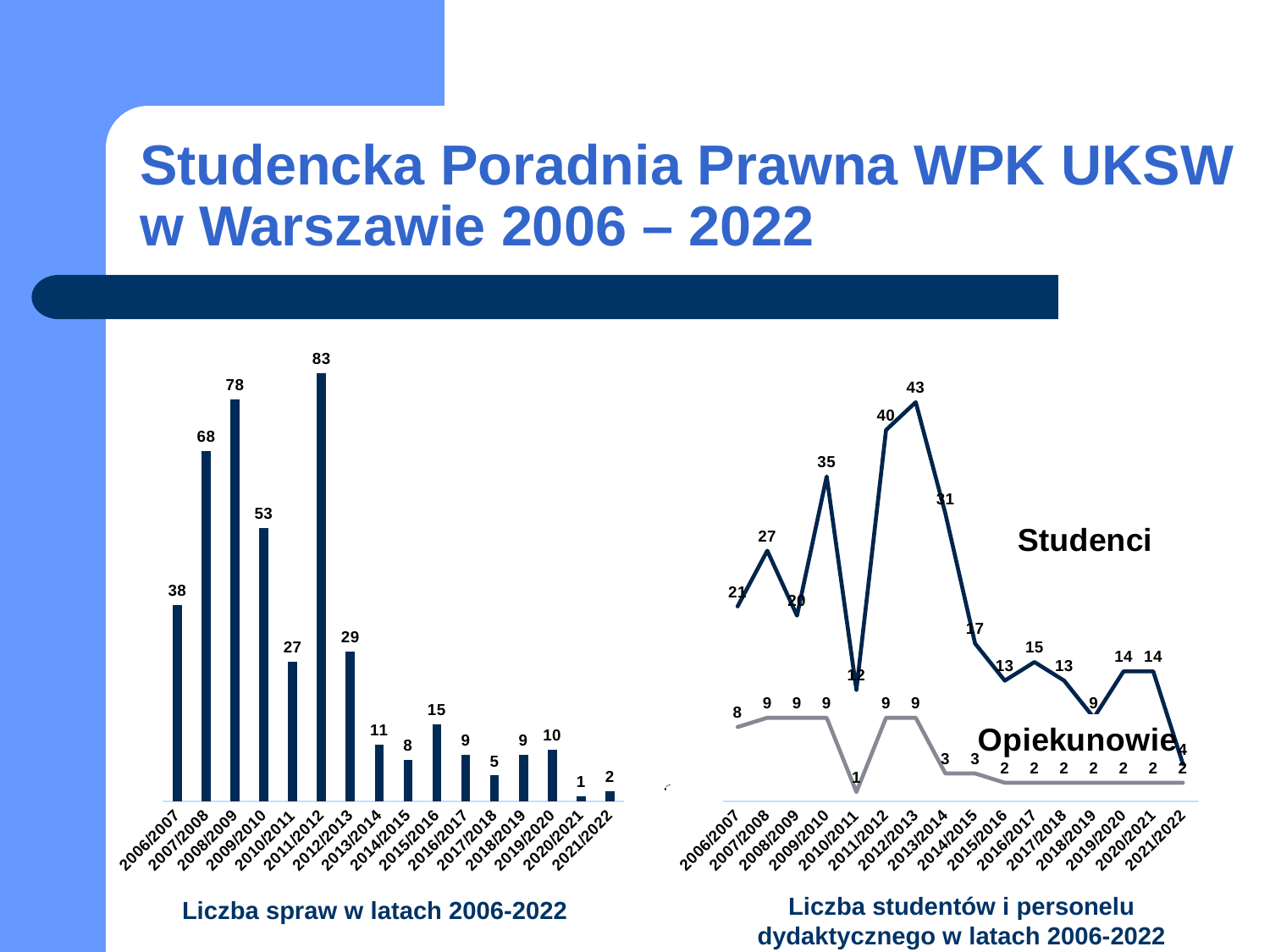
In the chart 'Liczba spraw w latach 2006-2022', which is larger, the value for 2010/2011 or 2012/2013? 2012/2013 In the chart 'Liczba spraw w latach 2006-2022', what is the difference between the values for 2008/2009 and 2009/2010? 25 How many series are plotted in the chart 'Liczba studentów i personelu dydaktycznego w latach 2006-2022'? 2 How many years are shown on the x axis of the chart 'Liczba spraw w latach 2006-2022'? 16 In the chart 'Liczba studentów i personelu dydaktycznego w latach 2006-2022', what is the value of Opiekunowie for 2010/2011? 1 In the chart 'Liczba spraw w latach 2006-2022', what is the value for 2011/2012? 83 What kind of chart is 'Liczba spraw w latach 2006-2022'? bar chart In the chart 'Liczba spraw w latach 2006-2022', which year has the lowest value? 2020/2021 In the chart 'Liczba studentów i personelu dydaktycznego w latach 2006-2022', what is the value of Studenci for 2012/2013? 43 In the chart 'Liczba studentów i personelu dydaktycznego w latach 2006-2022', what is the difference between Studenci and Opiekunowie in 2021/2022? 2 In the chart 'Liczba spraw w latach 2006-2022', which year has the highest value? 2011/2012 What kind of chart is 'Liczba studentów i personelu dydaktycznego w latach 2006-2022'? line chart